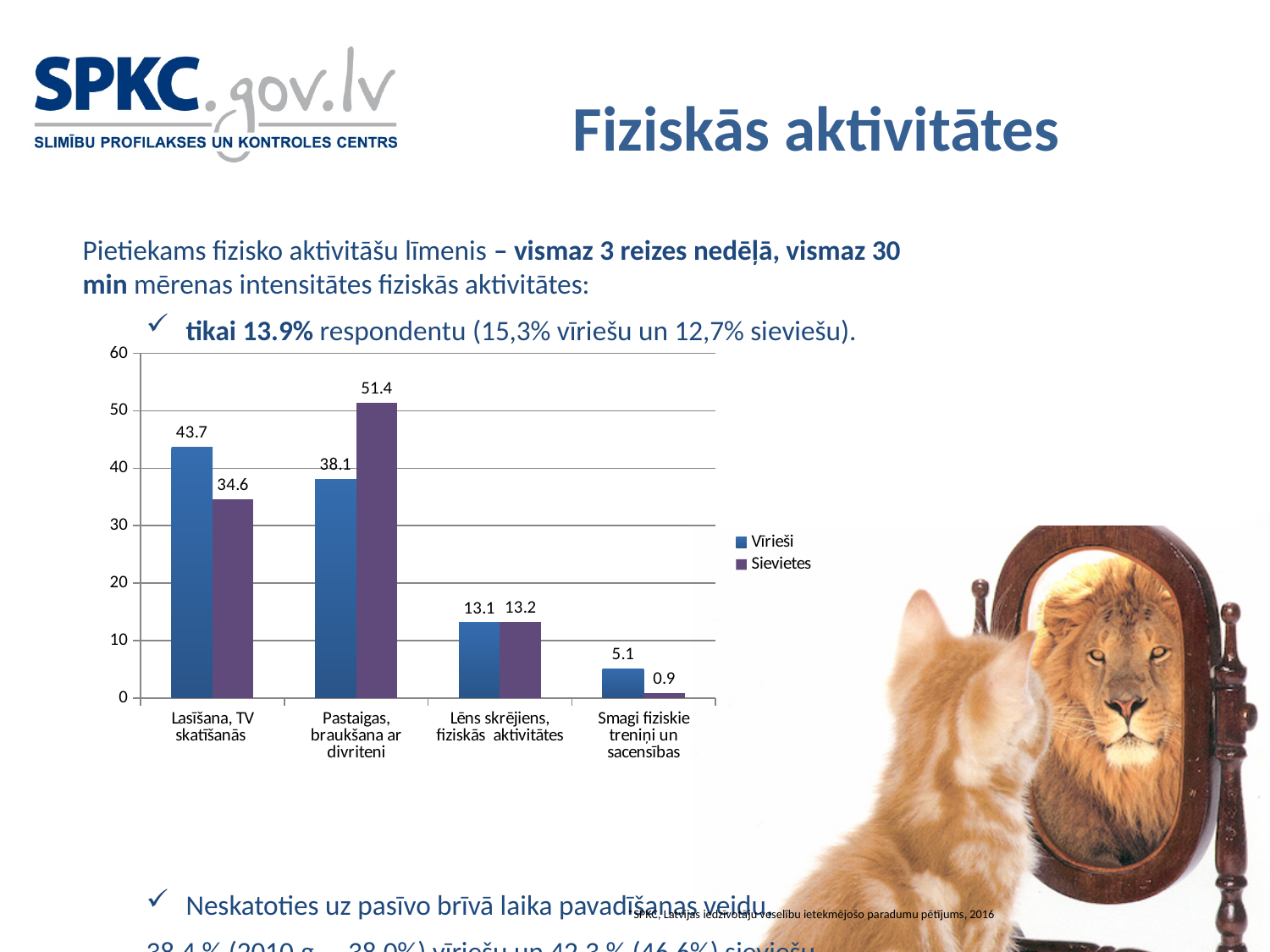
Which category has the lowest value for Vīrieši? Smagi fiziskie treniņi un sacensības What is the difference between the Vīrieši and Sievietes values in the category "Lasīšana, TV skatīšanās"? 9.1 What kind of chart is shown on the slide? bar chart In the category "Pastaigas, braukšana ar divriteni", which series has the larger value, Vīrieši or Sievietes? Sievietes What are the two series named in the chart legend? Vīrieši and Sievietes Is the value for Vīrieši in "Pastaigas, braukšana ar divriteni" greater or less than 30? greater How many series does the chart legend list? 2 How many categories are shown on the x axis of the chart? 4 What is the value for Vīrieši in the category "Lasīšana, TV skatīšanās"? 43.7 Which category has the highest value for Sievietes? Pastaigas, braukšana ar divriteni What is the value for Sievietes in the category "Pastaigas, braukšana ar divriteni"? 51.4 What is the value for Sievietes in the category "Smagi fiziskie treniņi un sacensības"? 0.9